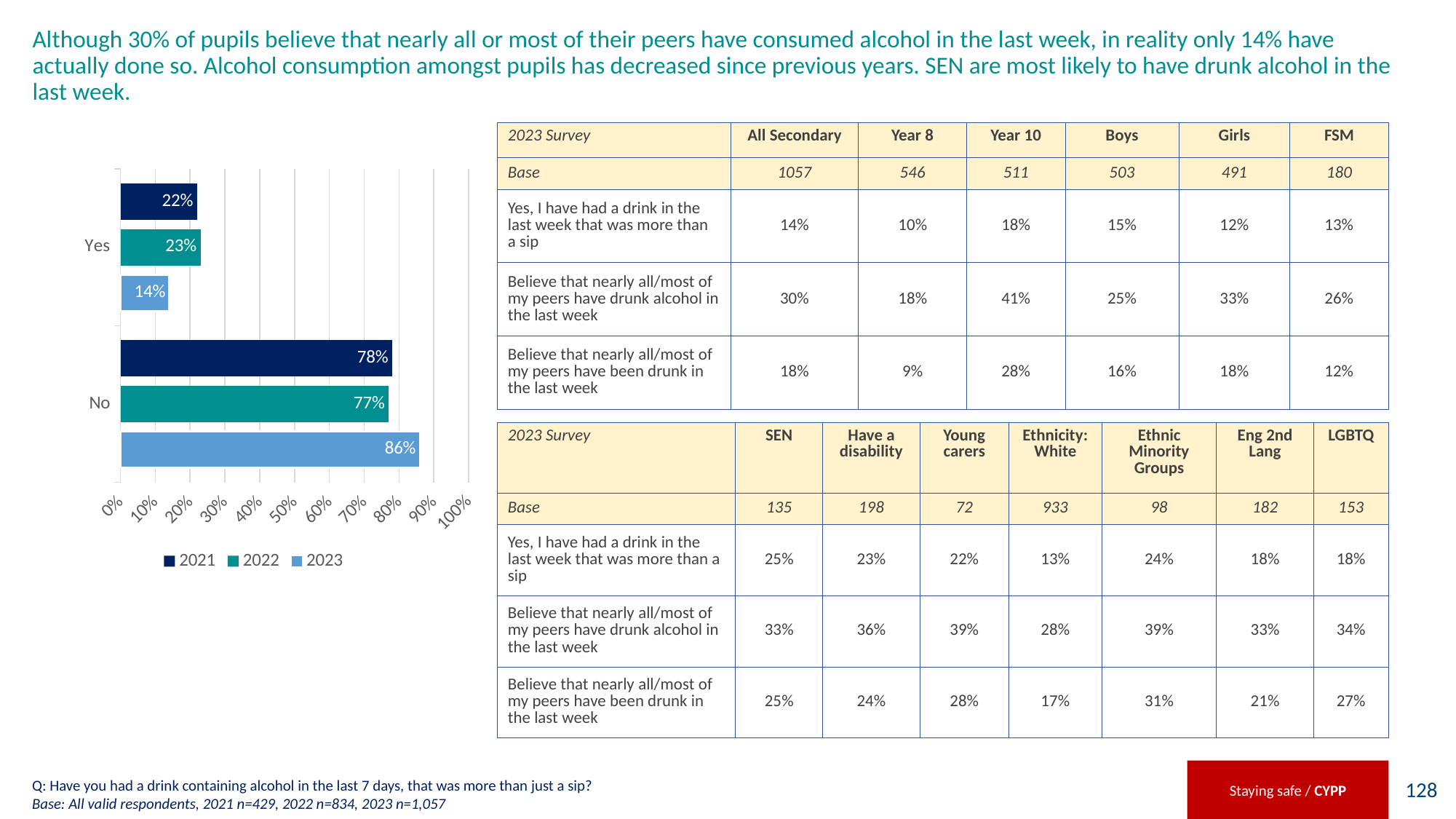
Which year has the highest value for 'No'? 2023 What is the value for 'No' in 2023? 86% What is the value for 'Yes' in 2022? 23% What is the difference between the 'Yes' values for 2022 and 2023? 9 percentage points Which is larger: the 'No' value for 2021 or for 2022? 2021 What is the value for 'No' in 2021? 78% Is the value for 'No' in 2023 greater or less than 80%? greater Which year has the lowest value for 'Yes'? 2023 What kind of chart is shown on the slide? Bar chart What is the value for 'Yes' in 2023? 14% How many categories are shown on the chart? 2 How many series does the legend list? 3